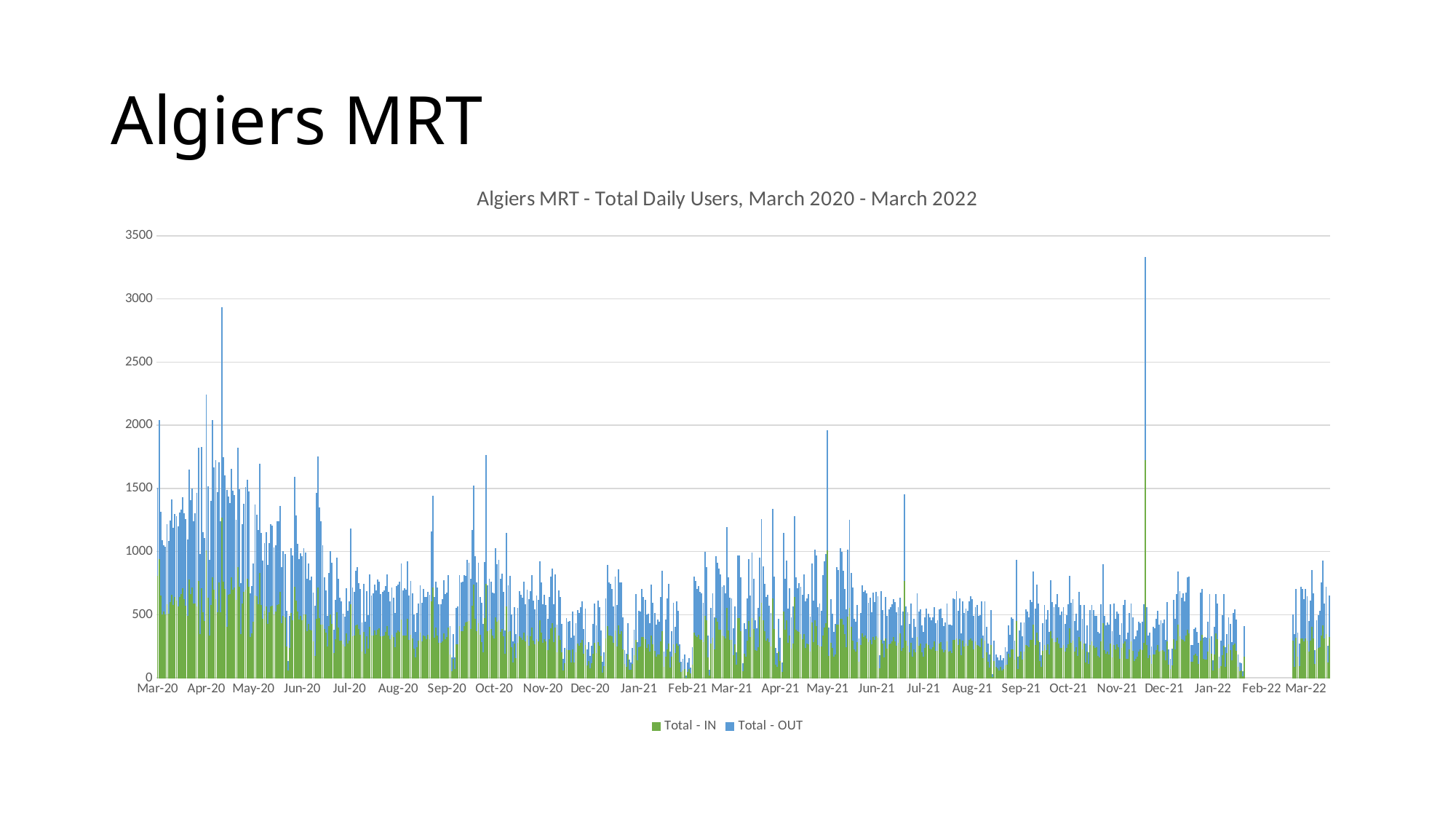
Which series generally makes up the larger part of each bar, Total - IN or Total - OUT? Total - OUT Do the daily totals generally rise or fall from Mar-20 to Mar-22? fall How many month labels are shown on the x axis? 25 What are the two series named in the legend? Total - IN and Total - OUT Is the tallest bar in May-21 greater or less than 1500? greater Which month on the x axis shows a gap with almost no bars plotted? Feb-22 What kind of chart is shown on the slide? Stacked bar chart What is the title of the chart? Algiers MRT - Total Daily Users, March 2020 - March 2022 How many series does the legend list? 2 Is the tallest bar in Jan-21 greater or less than 1000? less Is the tallest bar in Apr-20 greater or less than 2500? greater